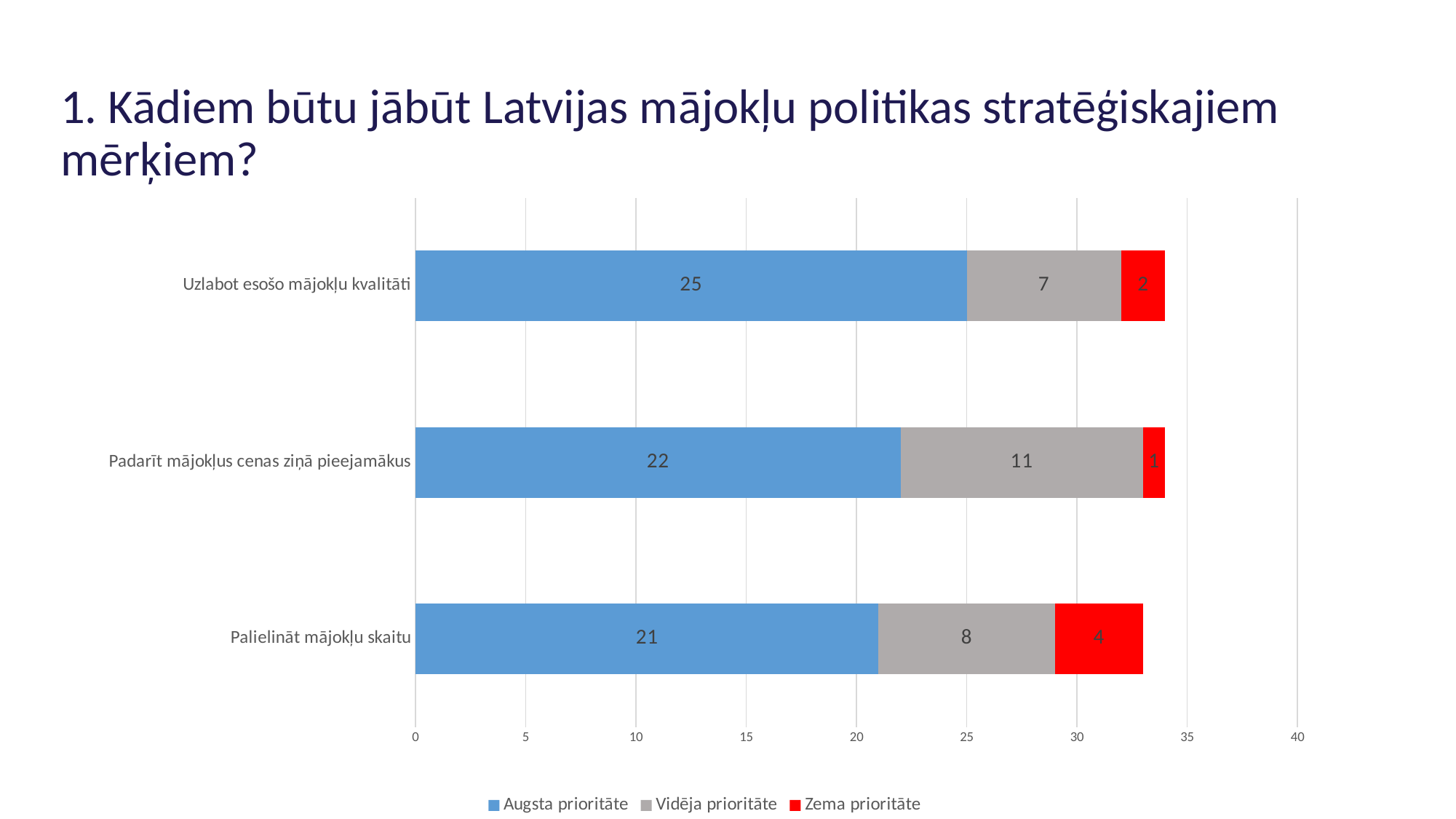
What is the total of the stacked bar for "Uzlabot esošo mājokļu kvalitāti"? 34 What is the value of "Vidēja prioritāte" for "Padarīt mājokļus cenas ziņā pieejamākus"? 11 What kind of chart is shown on the slide? Stacked bar chart What is the value of "Zema prioritāte" for "Palielināt mājokļu skaitu"? 4 Which category has the lowest "Zema prioritāte" value? Padarīt mājokļus cenas ziņā pieejamākus How many series does the legend list? 3 What is the difference between the "Augsta prioritāte" values for "Uzlabot esošo mājokļu kvalitāti" and "Palielināt mājokļu skaitu"? 4 Which category has the highest "Augsta prioritāte" value? Uzlabot esošo mājokļu kvalitāti What is the total of the stacked bar for "Palielināt mājokļu skaitu"? 33 How many categories are shown on the chart? 3 What is the value of "Augsta prioritāte" for "Uzlabot esošo mājokļu kvalitāti"? 25 Which is larger: the "Vidēja prioritāte" value for "Padarīt mājokļus cenas ziņā pieejamākus" or for "Palielināt mājokļu skaitu"? Padarīt mājokļus cenas ziņā pieejamākus